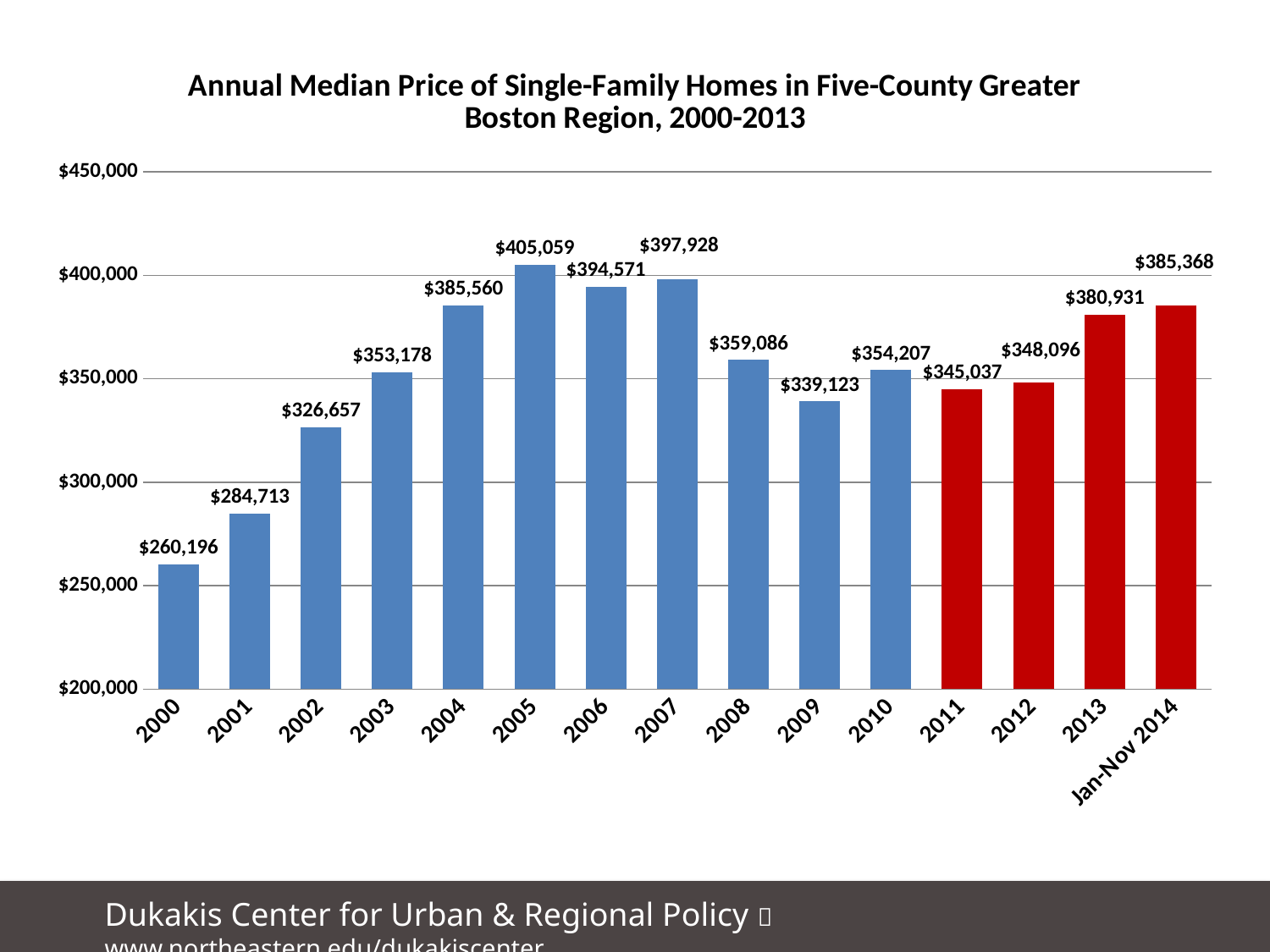
Which year has the lowest median price? 2000 What kind of chart is shown on the slide? Bar chart Which year has the highest median price? 2005 How many bars are shown in the chart? 15 What is the difference between the median price in 2005 and in 2000? $144,863 Did the median price rise or fall from 2000 to 2005? Rise What is the median price shown for 2009? $339,123 What is the difference between the median price in 2013 and in 2012? $32,835 Is the median price for 2002 greater or less than $300,000? greater What is the median price shown for Jan-Nov 2014? $385,368 What is the median price shown for 2005? $405,059 Which is larger, the median price in 2004 or in 2008? 2004